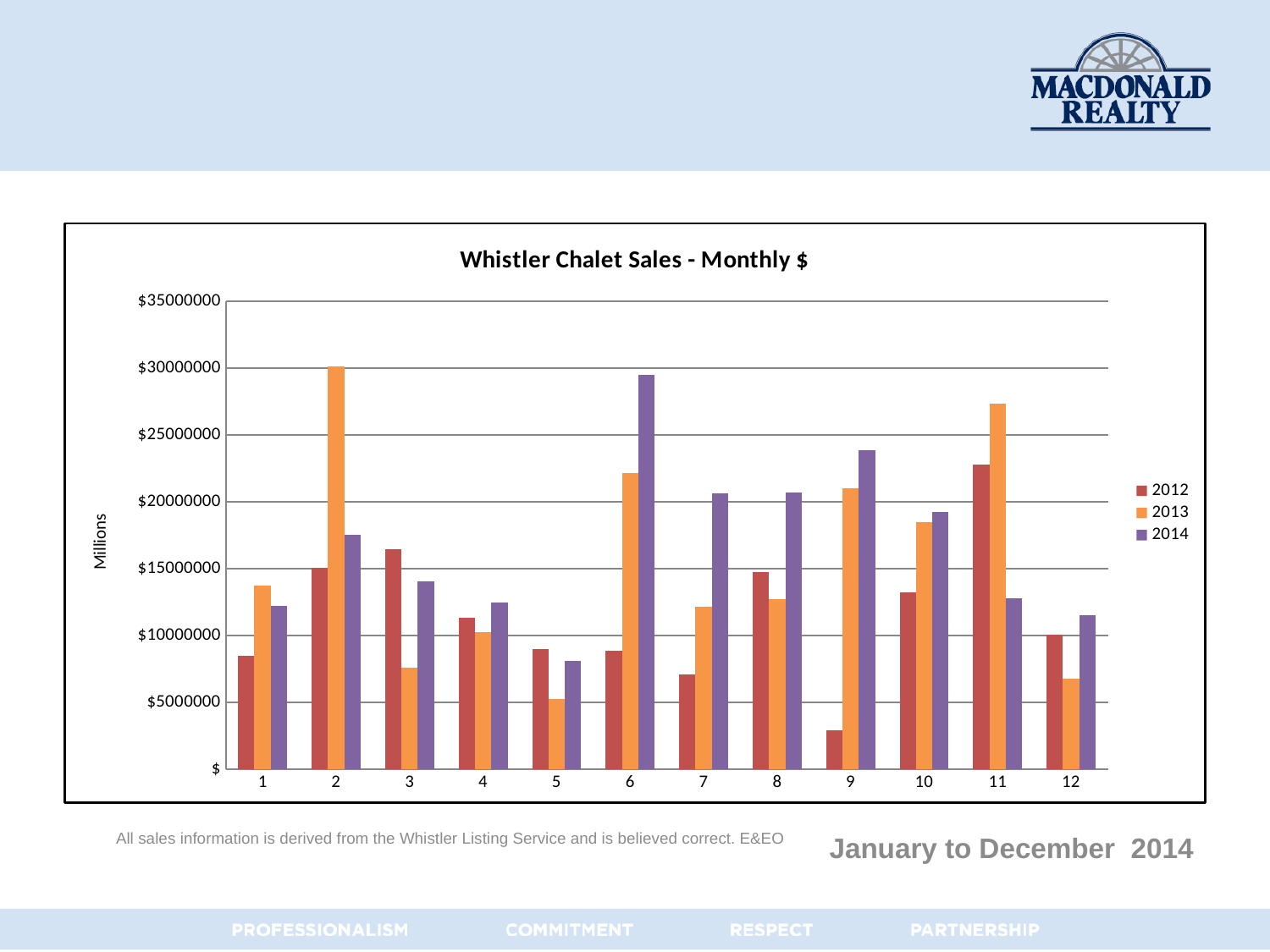
How many series does the legend list? 3 In which month did the 2014 series reach its highest value? 6 In which month did the 2013 series reach its highest value? 2 Is the 2012 value for month 9 greater or less than $5000000? less For month 11, which series has the larger value, 2012 or 2013? 2013 In which month did the 2012 series reach its highest value? 11 In which month was the 2012 value the lowest? 9 How many months (categories) are shown on the x axis? 12 In which month was the 2013 value the lowest? 5 What is the title of the chart? Whistler Chalet Sales - Monthly $ What type of chart is shown on the slide? Bar chart Is the 2013 value for month 2 greater or less than $25000000? greater